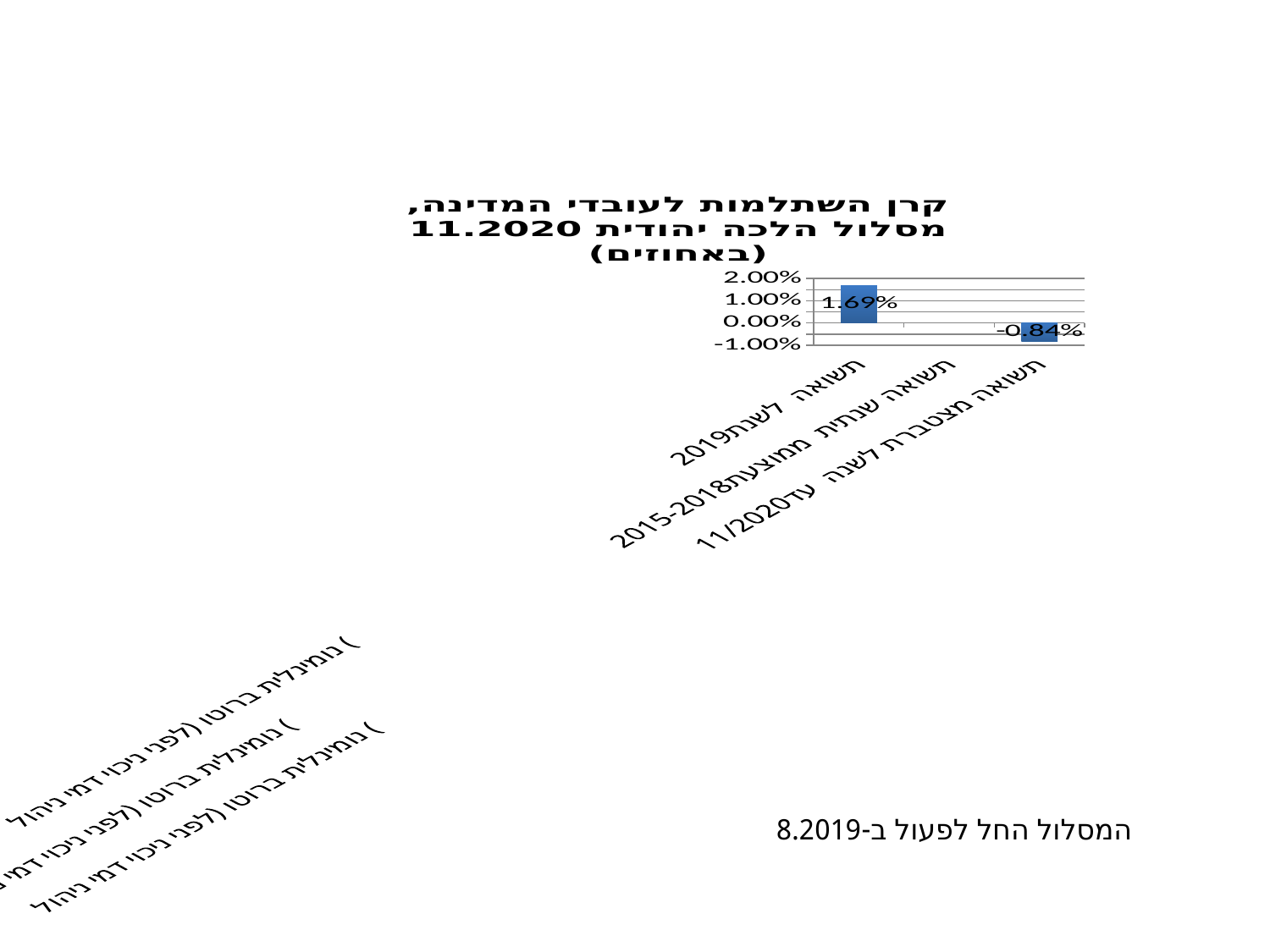
What is the highest value shown on the chart's y axis? 2.00% What is the value for תשואה לשנת 2019? 1.69% What kind of chart is shown on the slide? bar chart What is the value for תשואה מצטברת לשנה עד 11/2020? -0.84% Which is larger, the value for תשואה לשנת 2019 or the value for תשואה מצטברת לשנה עד 11/2020? תשואה לשנת 2019 What is the title of the chart? קרן השתלמות לעובדי המדינה, מסלול הלכה יהודית 11.2020 (באחוזים) How many categories are shown on the x axis of the chart? 3 What is the difference between the value for תשואה לשנת 2019 and the value for תשואה מצטברת לשנה עד 11/2020? 2.53% Which category has the highest value? תשואה לשנת 2019 Which category has the lowest plotted value? תשואה מצטברת לשנה עד 11/2020 Is the value for תשואה מצטברת לשנה עד 11/2020 greater or less than 0.00%? less Is the value for תשואה לשנת 2019 greater or less than 1.00%? greater